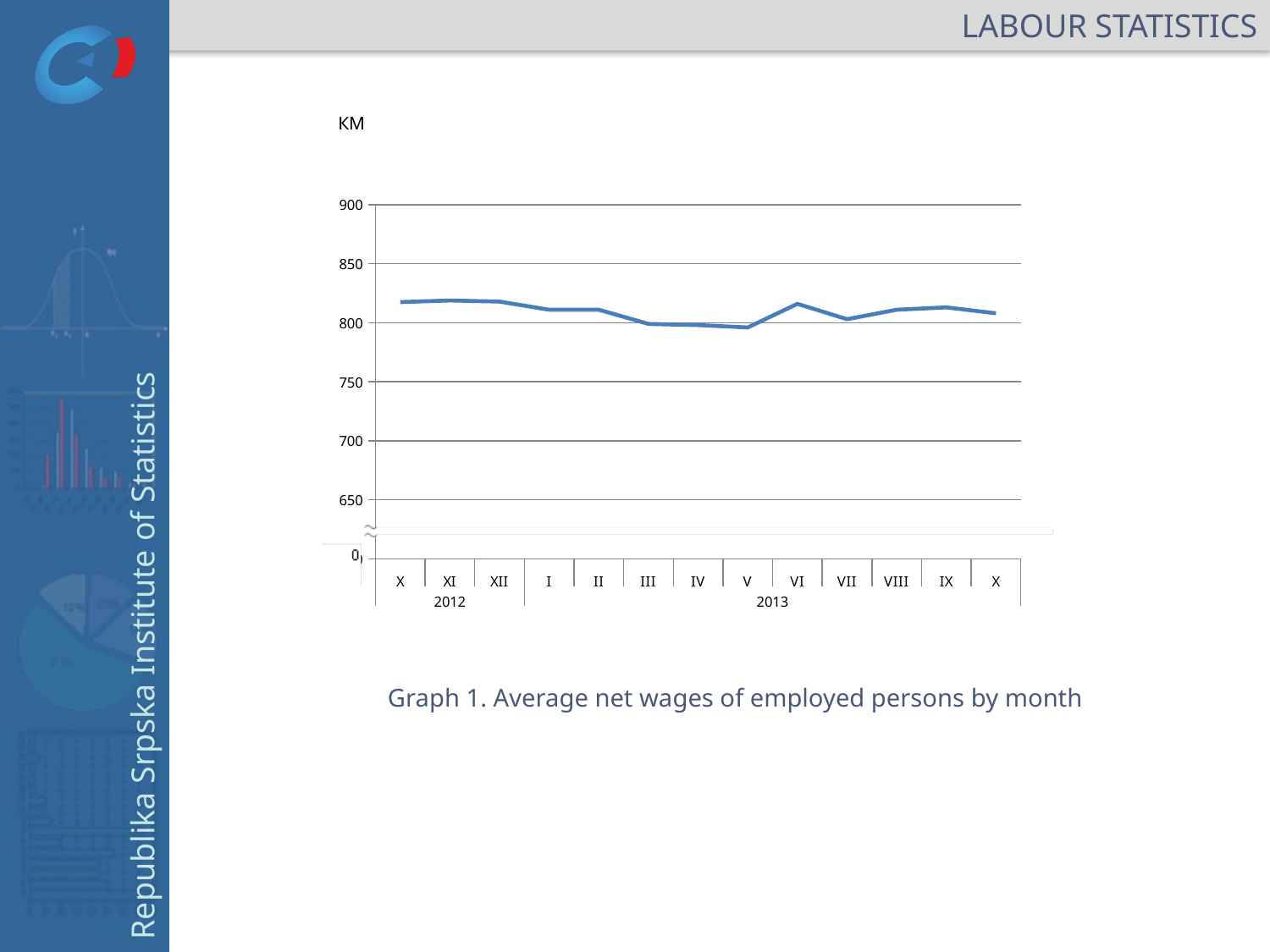
Is the value for VI 2013 greater or less than 800? greater Which is larger, the value for VI 2013 or the value for VII 2013? VI 2013 Is the value for XI 2012 greater or less than 850? less How many monthly data points are plotted on the line in Graph 1? 13 What kind of chart is Graph 1? line chart Which is larger, the value for X 2012 or the value for III 2013? X 2012 Do the values rise or fall from X 2012 to V 2013? fall Is the value for I 2013 greater or less than 750? greater What unit is shown on the vertical axis of Graph 1? KM What is the title of Graph 1? Average net wages of employed persons by month Which is larger, the value for XII 2012 or the value for V 2013? XII 2012